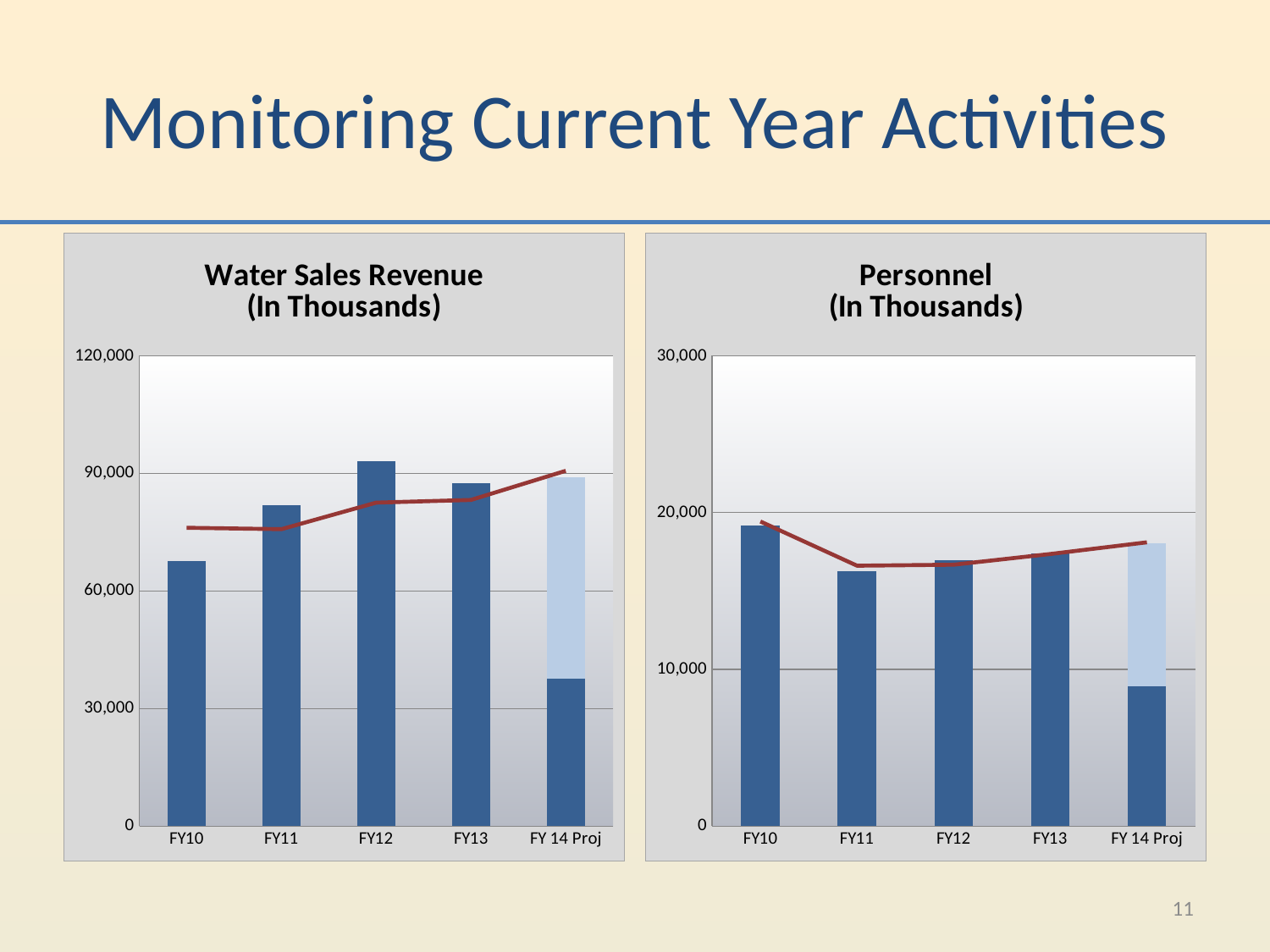
In the Personnel chart, which fiscal year among FY10 to FY13 has the tallest bar? FY10 In the Personnel chart, is the value for FY11 greater or less than 20,000? less In the Water Sales Revenue chart, which fiscal year has the tallest bar? FY12 In the Water Sales Revenue chart, which bar is taller, FY11 or FY13? FY13 What is the title of the chart on the right side of the slide? Personnel (In Thousands) In the Water Sales Revenue chart, how many fiscal year categories are shown on the x axis? 5 In the Water Sales Revenue chart, is the value for FY10 greater or less than 60,000? greater In the Personnel chart, how many fiscal year categories are shown on the x axis? 5 In the Water Sales Revenue chart, is the value for FY12 greater or less than 90,000? greater In the Water Sales Revenue chart, what kind of chart is used to show the fiscal year values? Combination bar and line chart In the Personnel chart, which bar is taller, FY10 or FY11? FY10